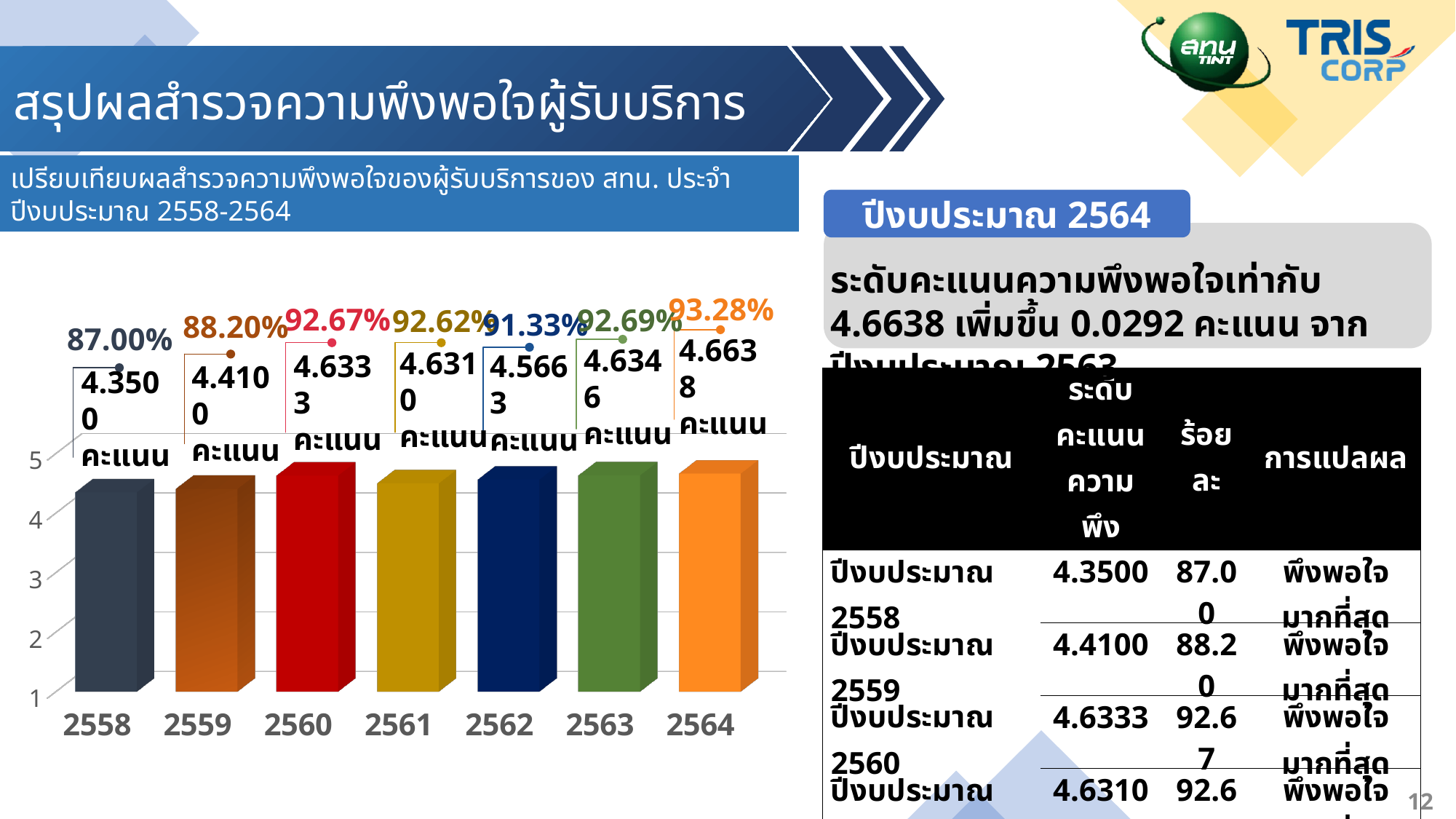
What colour is the bar for 2560? red How many years (bars) are shown in the bar chart? 7 What is the difference between the score for 2564 and the score for 2558? 0.3138 What percentage is shown above the bar for 2562? 91.33% Which year has the lowest score in the bar chart? 2558 What score value is shown for the year 2564 in the bar chart? 4.6638 คะแนน What percentage is shown above the bar for 2564? 93.28% Which year has the highest score in the bar chart? 2564 Which year has the larger score, 2562 or 2563? 2563 Is the score for 2559 greater or less than 4? greater What score value is shown for the year 2558 in the bar chart? 4.3500 คะแนน What kind of chart is used to show the satisfaction scores by year? bar chart